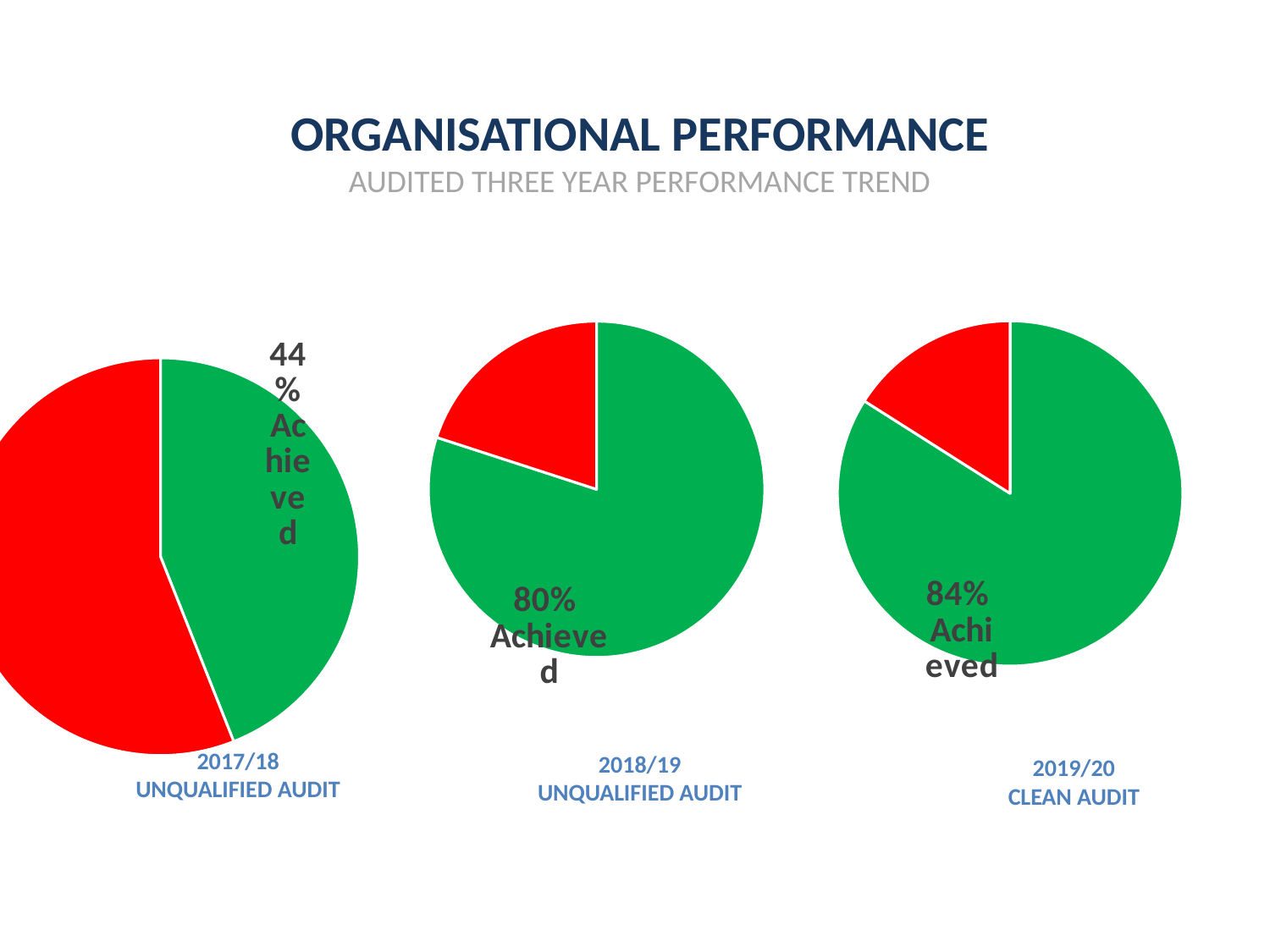
What type of chart is used to show the 2019/20 performance? Pie chart By how many percentage points did the achieved share rise from the 2018/19 pie chart to the 2019/20 pie chart? 4 By how many percentage points did the achieved share rise from the 2017/18 pie chart to the 2018/19 pie chart? 36 In the 2019/20 pie chart, what percentage is labelled as achieved? 84% In the 2018/19 pie chart, what percentage is labelled as achieved? 80% In the 2017/18 pie chart, what percentage is labelled as achieved? 44% Across the three pie charts, which year shows the highest achieved percentage? 2019/20 Which pie chart shows a larger achieved share, 2017/18 or 2018/19? 2018/19 Across the three pie charts, which year shows the lowest achieved percentage? 2017/18 What audit outcome is written under the 2019/20 pie chart? CLEAN AUDIT Does the achieved percentage rise or fall from 2017/18 to 2019/20 across the three pie charts? Rise How many pie charts are shown on the slide? 3